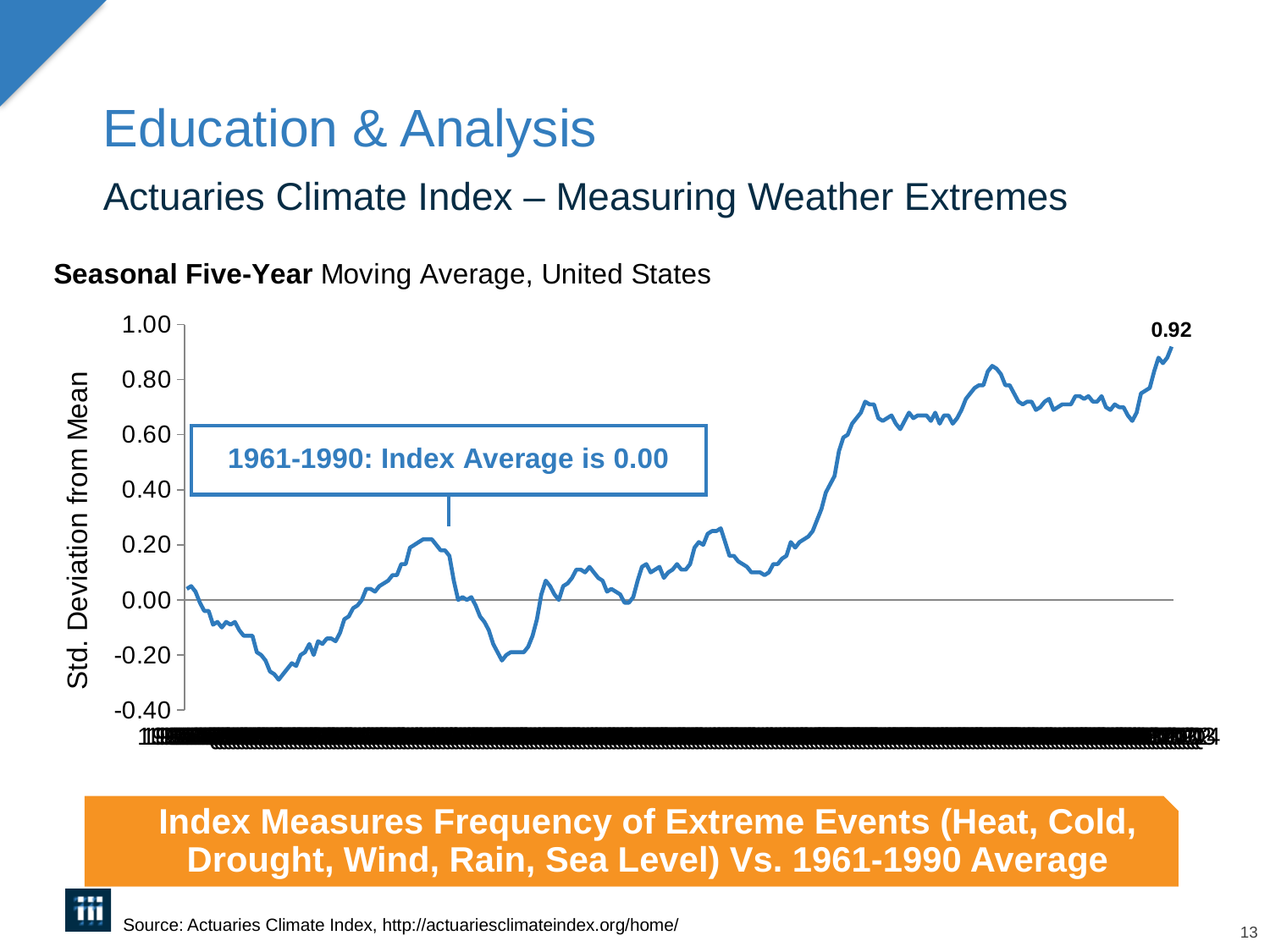
What is the title of the vertical axis? Std. Deviation from Mean Is the value at the start of the line greater or less than 0.20? less What is the highest value labeled on the chart? 0.92 Overall, does the line rise or fall from left to right? Rise What is the value printed as a data label at the end of the line? 0.92 How many lines are plotted on the chart? 1 Is the final value of the line greater or less than 0.80? greater What kind of chart is shown on the slide? Line chart Is the lowest point of the line greater or less than -0.20? less According to the annotation box on the chart, what is the index average for 1961-1990? 0.00